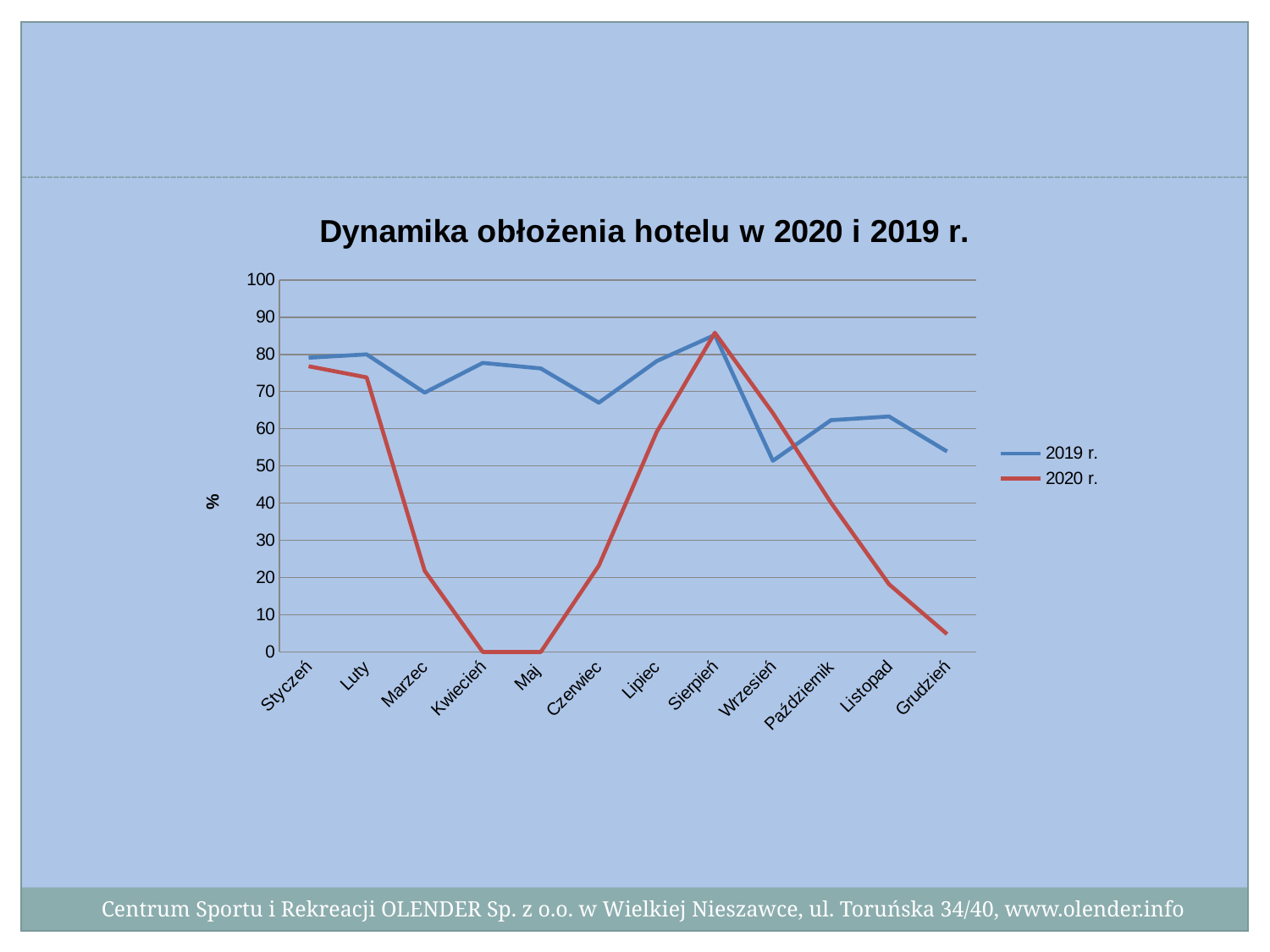
Which series has the higher value in Marzec, 2019 r. or 2020 r.? 2019 r. What is the label on the vertical axis? % What is the title of the chart? Dynamika obłożenia hotelu w 2020 i 2019 r. How many series does the legend list? 2 What is the value for 2020 r. in Kwiecień? 0 Is the value for 2020 r. in Grudzień greater or less than 10? less Does the 2020 r. series rise or fall from Maj to Sierpień? rise How many months are plotted along the x axis? 12 What kind of chart is shown on the slide? line chart Is the value for 2019 r. in Styczeń greater or less than 70? greater In which month does the 2020 r. series reach its highest value? Sierpień Is the value for 2020 r. in Marzec greater or less than 30? less